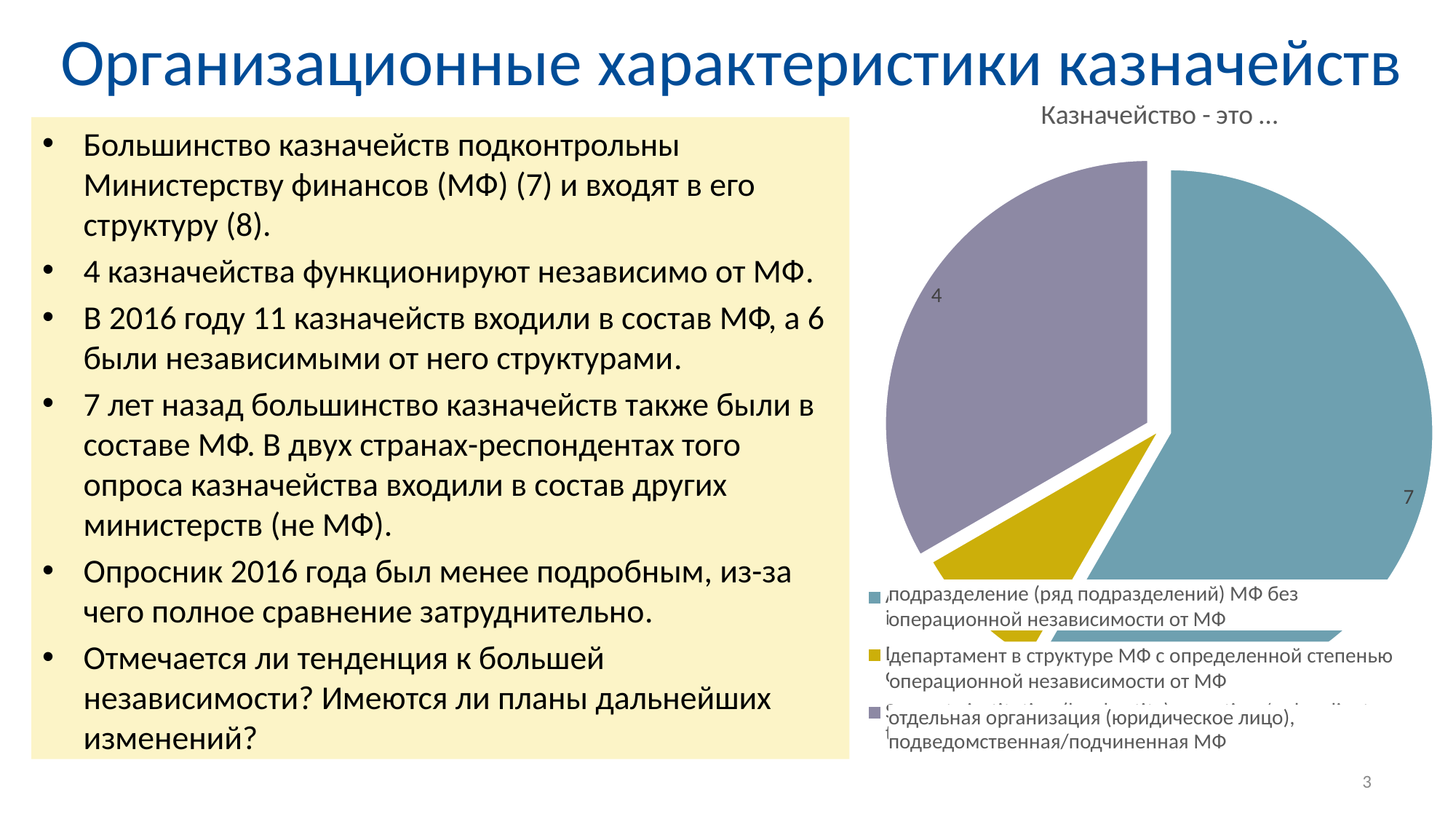
Which category has the largest slice of the pie? подразделение (ряд подразделений) МФ без операционной независимости от МФ What value is shown for the slice "подразделение (ряд подразделений) МФ без операционной независимости от МФ"? 7 What is the difference between the value for "подразделение (ряд подразделений) МФ без операционной независимости от МФ" and the value for "отдельная организация (юридическое лицо), подведомственная/подчиненная МФ"? 3 What is the title of the chart? Казначейство - это ... What value is shown for the slice "отдельная организация (юридическое лицо), подведомственная/подчиненная МФ"? 4 Which is larger: the slice for "подразделение (ряд подразделений) МФ без операционной независимости от МФ" or the slice for "отдельная организация (юридическое лицо), подведомственная/подчиненная МФ"? подразделение (ряд подразделений) МФ без операционной независимости от МФ Which category has the smallest slice of the pie? департамент в структуре МФ с определенной степенью операционной независимости от МФ How many categories does the chart's legend list? 3 What kind of chart is shown on the slide? pie chart What colour is the slice for "департамент в структуре МФ с определенной степенью операционной независимости от МФ"? yellow